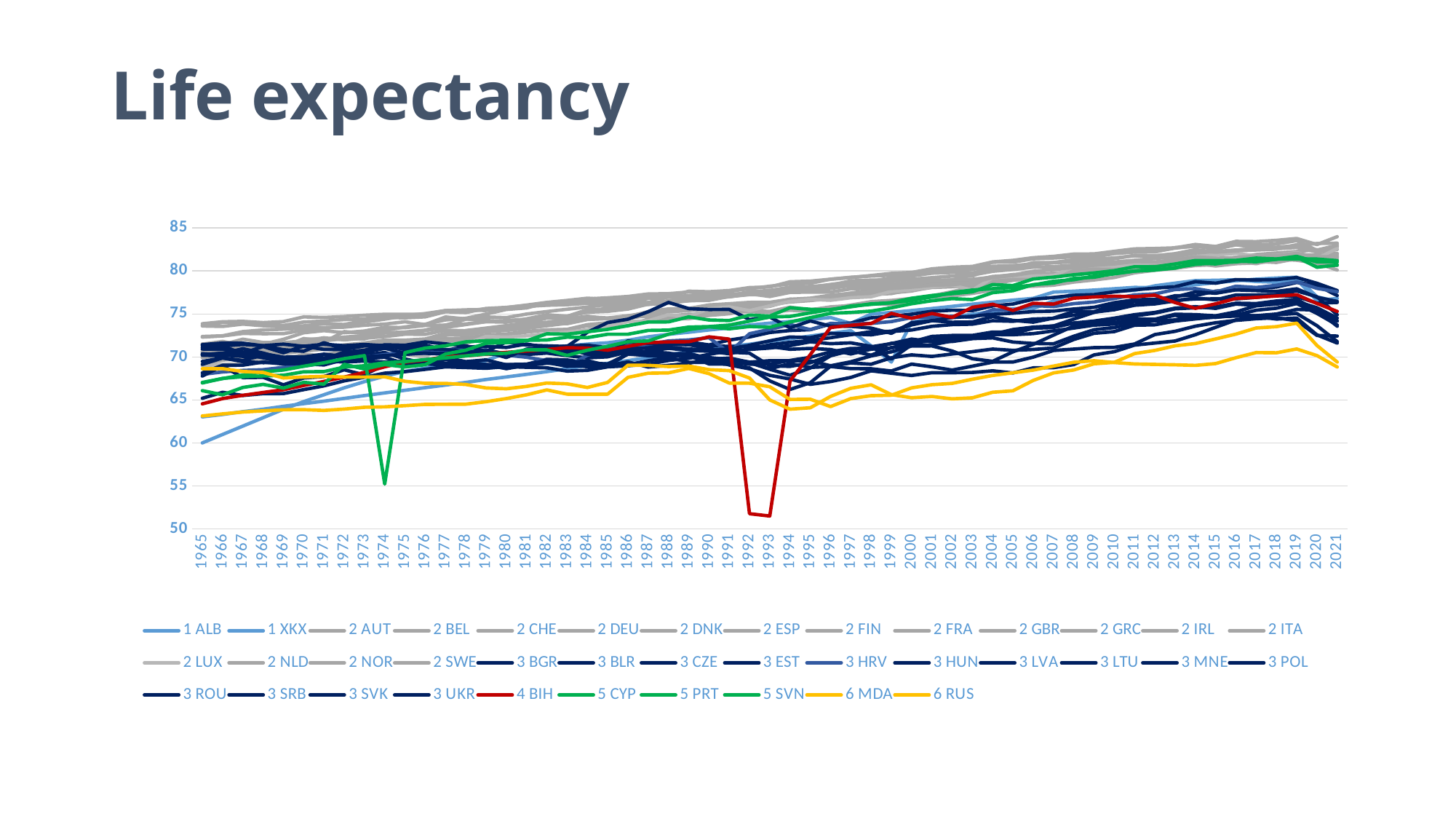
What is the last year shown on the x axis? 2021 Do the life expectancy values generally rise or fall from 1965 to 2021? rise Is the value for 4 BIH in 1993 greater or less than 55? less How many series does the legend list? 38 What colour is the line for 4 BIH? red What is the title of the chart? Life expectancy How many years are shown along the x axis? 57 What is the first year shown on the x axis? 1965 What kind of chart is shown on the slide? line chart What is the highest value marked on the y axis? 85 Is the value for 1 ALB in 1965 greater or less than 65? less Is the value for 4 BIH in 2021 greater or less than 70? greater